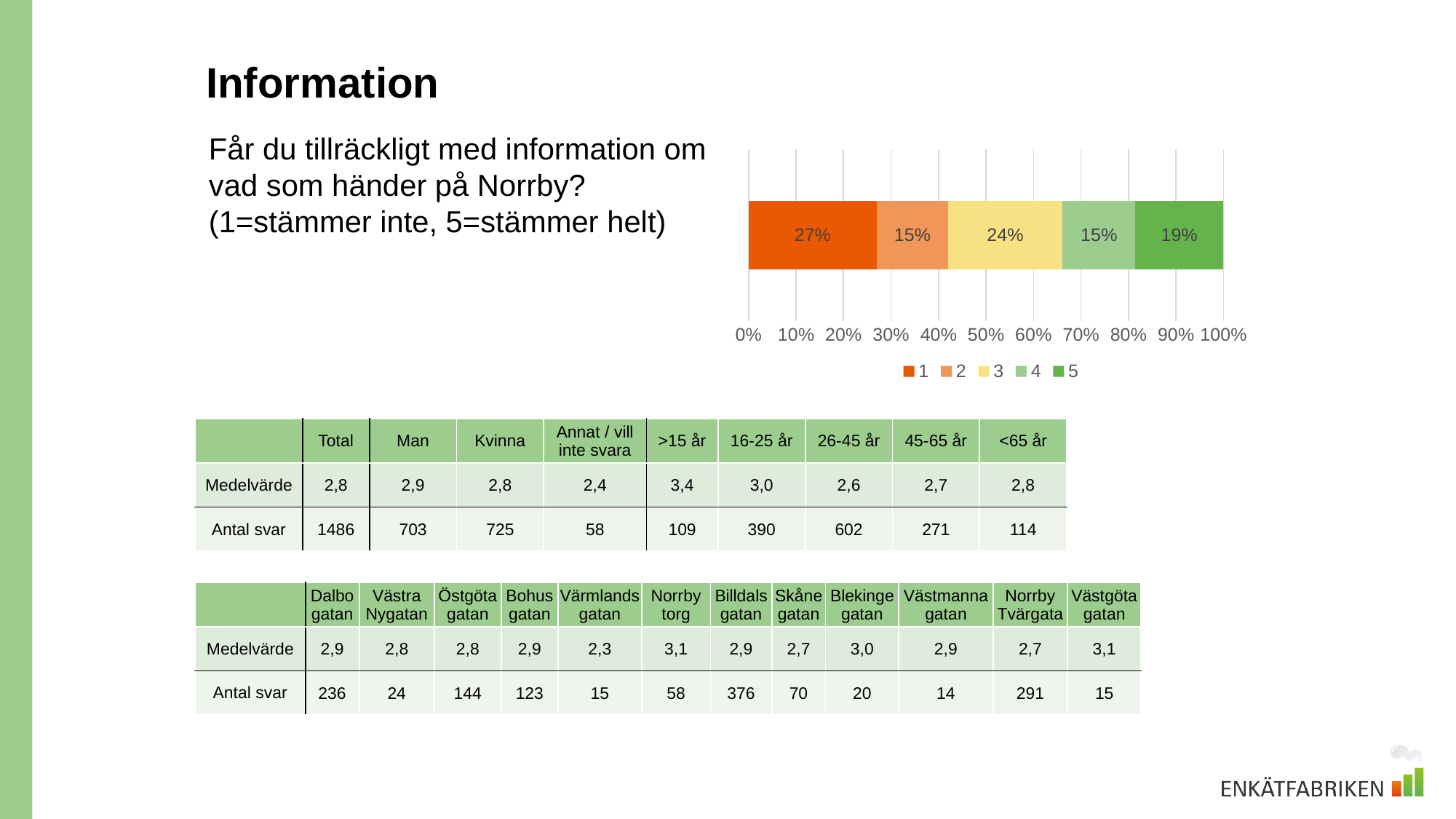
What kind of chart is shown on the slide? Stacked bar chart What is the combined share of respondents who answered 4 or 5? 34% Which is larger: the share answering 3 or the share answering 5? 3 What is the total of all segments in the stacked bar? 100% How many series does the legend list? 5 What percentage of respondents answered 5 (stämmer helt)? 19% What percentage of respondents answered 3? 24% What percentage of respondents answered 1 (stämmer inte)? 27% Which response option has the largest share in the bar? 1 Is the share answering 1 greater or less than 20%? greater What colour is the segment for response 1 in the chart? Dark orange What is the difference in percentage points between the share answering 1 and the share answering 5? 8